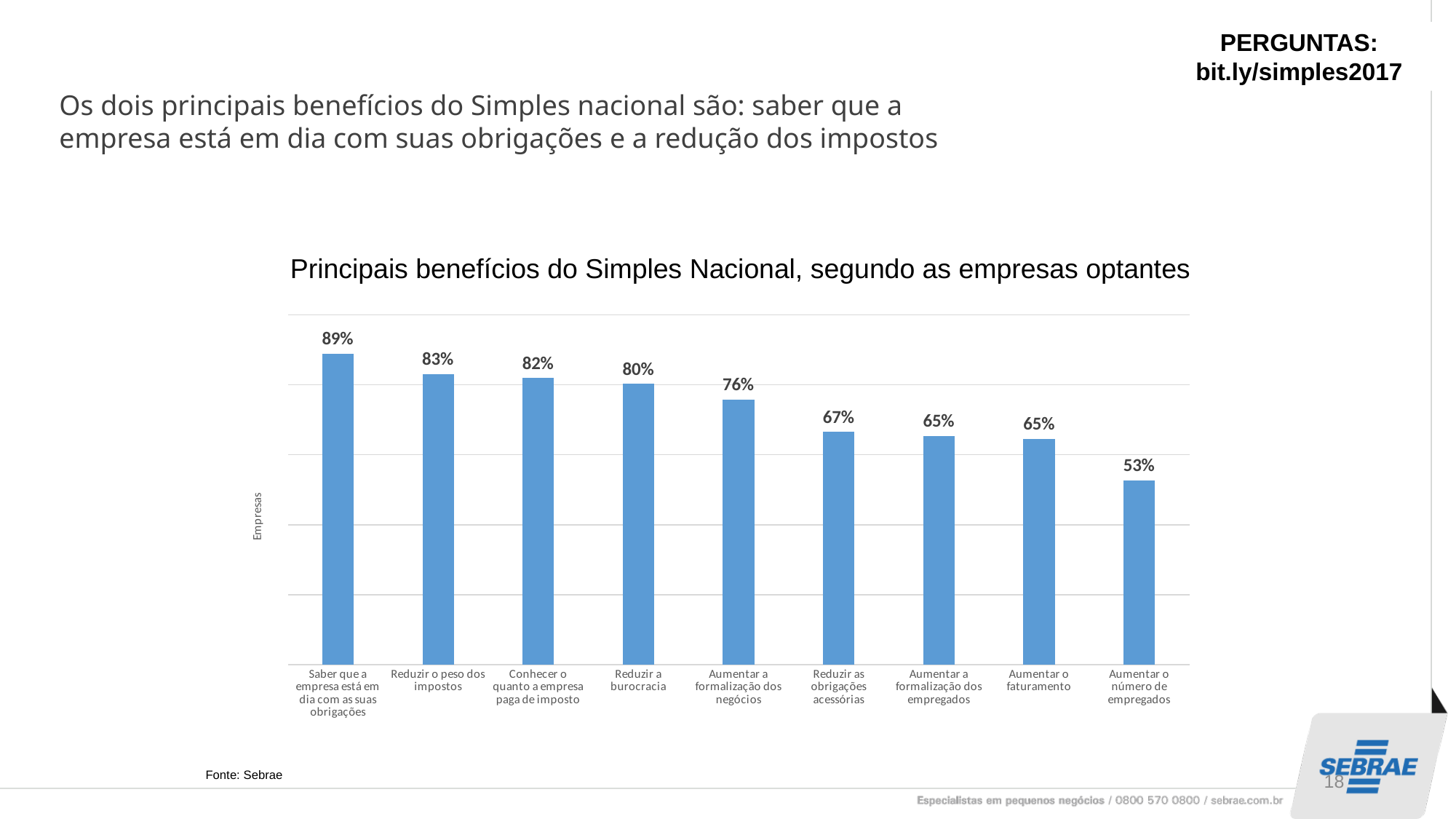
Which category has the highest value? Saber que a empresa está em dia com as suas obrigações What kind of chart is shown on the slide? Bar chart What is the value for "Reduzir as obrigações acessórias"? 67% Which is larger: the value for "Conhecer o quanto a empresa paga de imposto" or the value for "Aumentar a formalização dos negócios"? Conhecer o quanto a empresa paga de imposto Which category has the lowest value? Aumentar o número de empregados What is the value for "Reduzir a burocracia"? 80% Do the values rise or fall from left to right across the categories? Fall What is the value for "Aumentar o número de empregados"? 53% What is the title of the chart? Principais benefícios do Simples Nacional, segundo as empresas optantes What is the value for "Reduzir o peso dos impostos"? 83% What is the difference between the values for "Saber que a empresa está em dia com as suas obrigações" and "Aumentar o número de empregados"? 36% How many categories are shown in the chart? 9